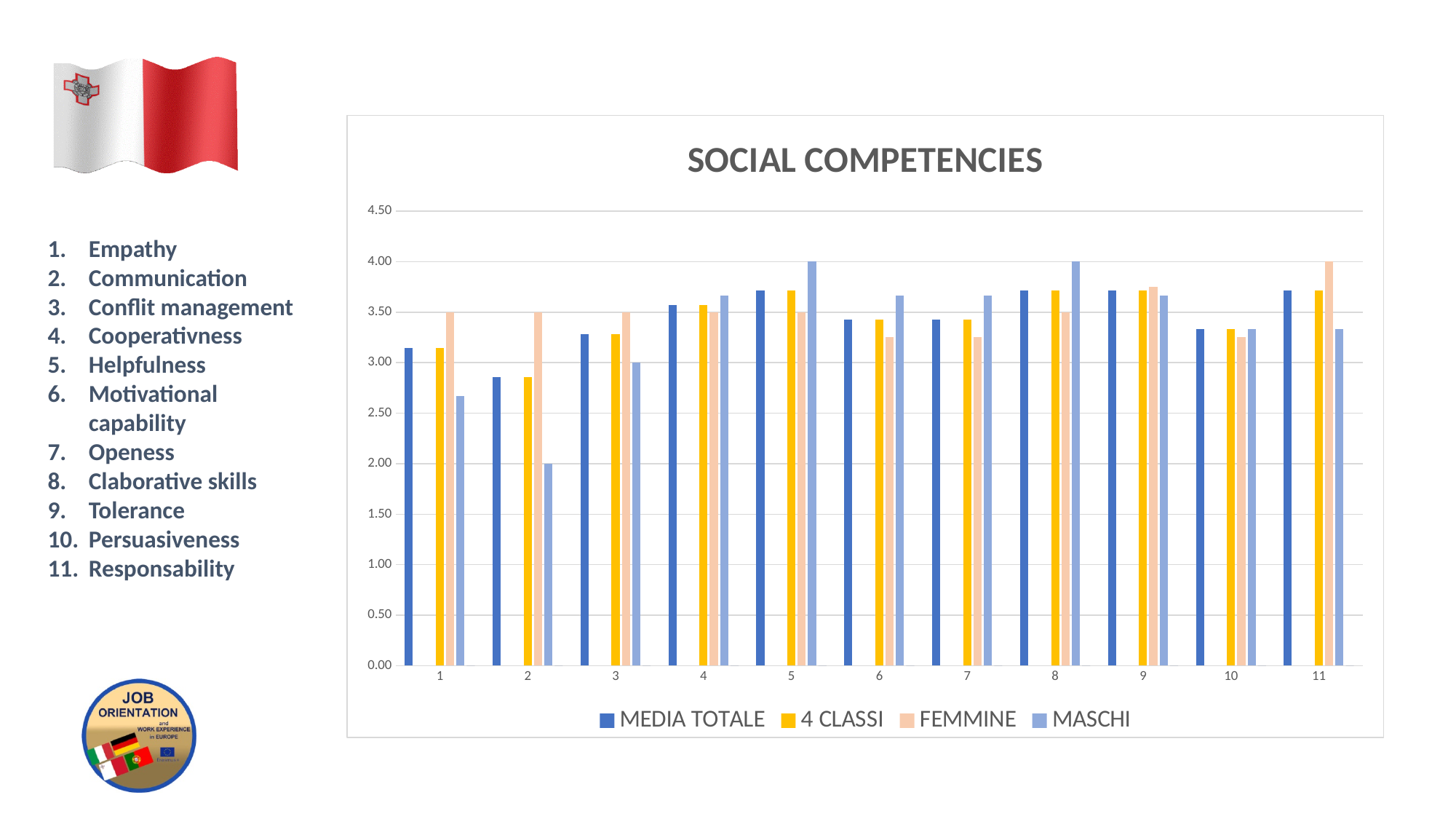
What is the MASCHI value for category 5? 4.00 How many series does the legend of the SOCIAL COMPETENCIES chart list? 4 For category 2, which is larger: the FEMMINE value or the MASCHI value? FEMMINE What is the MASCHI value for category 3? 3.00 For which category is the MASCHI value lowest? 2 What is the title of the chart? SOCIAL COMPETENCIES Is the MEDIA TOTALE value for category 1 greater or less than 3.00? greater What is the FEMMINE value for category 11? 4.00 What is the MASCHI value for category 2? 2.00 How many categories are plotted along the x axis of the SOCIAL COMPETENCIES chart? 11 Is the 4 CLASSI value for category 2 greater or less than 3.00? less What kind of chart is shown on the slide? bar chart